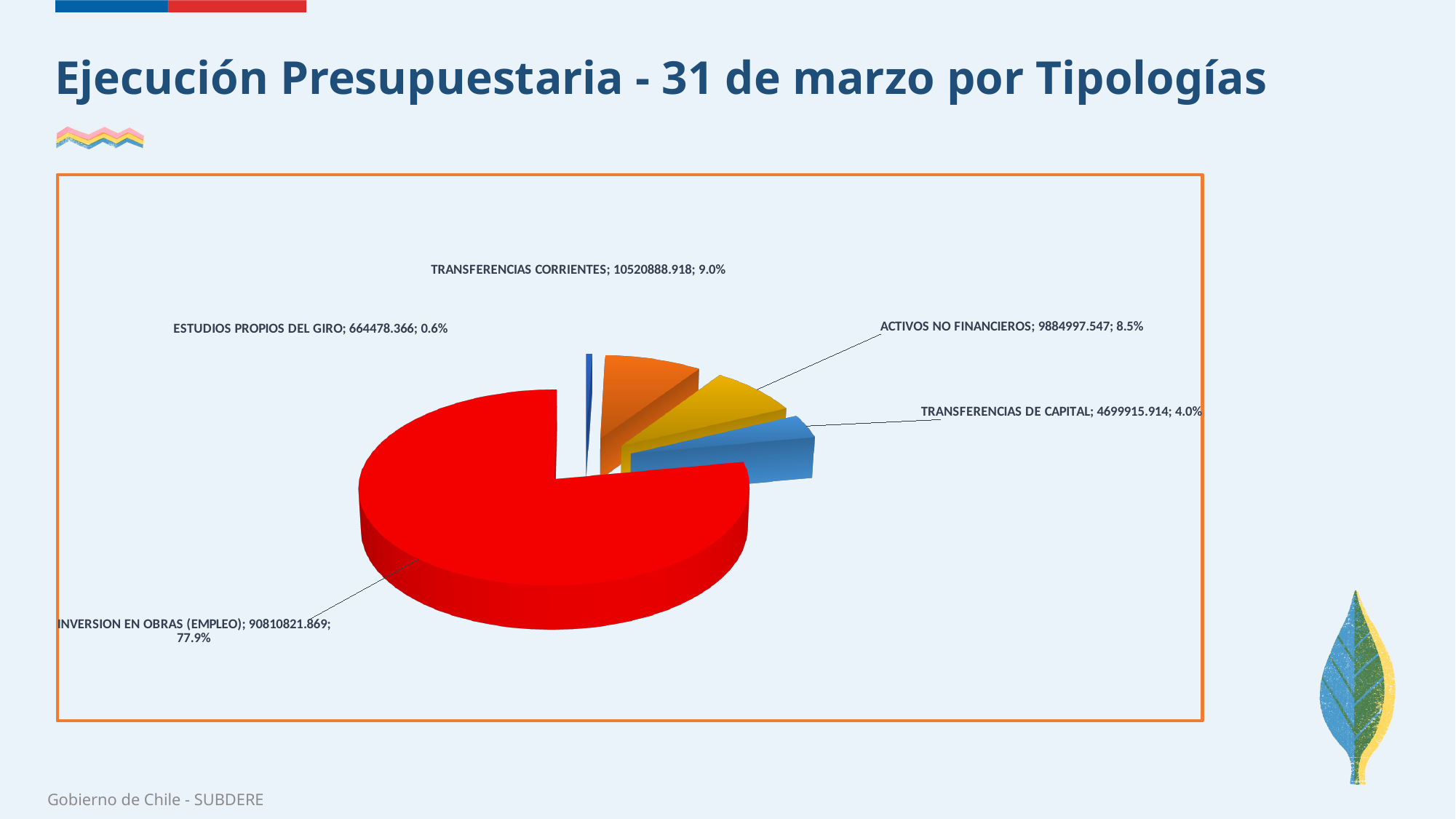
What is the title of the slide containing the chart? Ejecución Presupuestaria - 31 de marzo por Tipologías How many slices does the pie chart have? 5 What type of chart is shown on the slide? Pie chart What is the value shown for TRANSFERENCIAS DE CAPITAL? 4699915.914 What share of the pie does ESTUDIOS PROPIOS DEL GIRO represent? 0.6% What is the value shown for ACTIVOS NO FINANCIEROS? 9884997.547 Which is larger, ACTIVOS NO FINANCIEROS or TRANSFERENCIAS DE CAPITAL? ACTIVOS NO FINANCIEROS What is the difference in percentage share between TRANSFERENCIAS CORRIENTES and ACTIVOS NO FINANCIEROS? 0.5% What is the value shown for TRANSFERENCIAS CORRIENTES? 10520888.918 What share of the pie does INVERSION EN OBRAS (EMPLEO) represent? 77.9% Which category has the smallest slice of the pie? ESTUDIOS PROPIOS DEL GIRO Which category has the largest slice of the pie? INVERSION EN OBRAS (EMPLEO)